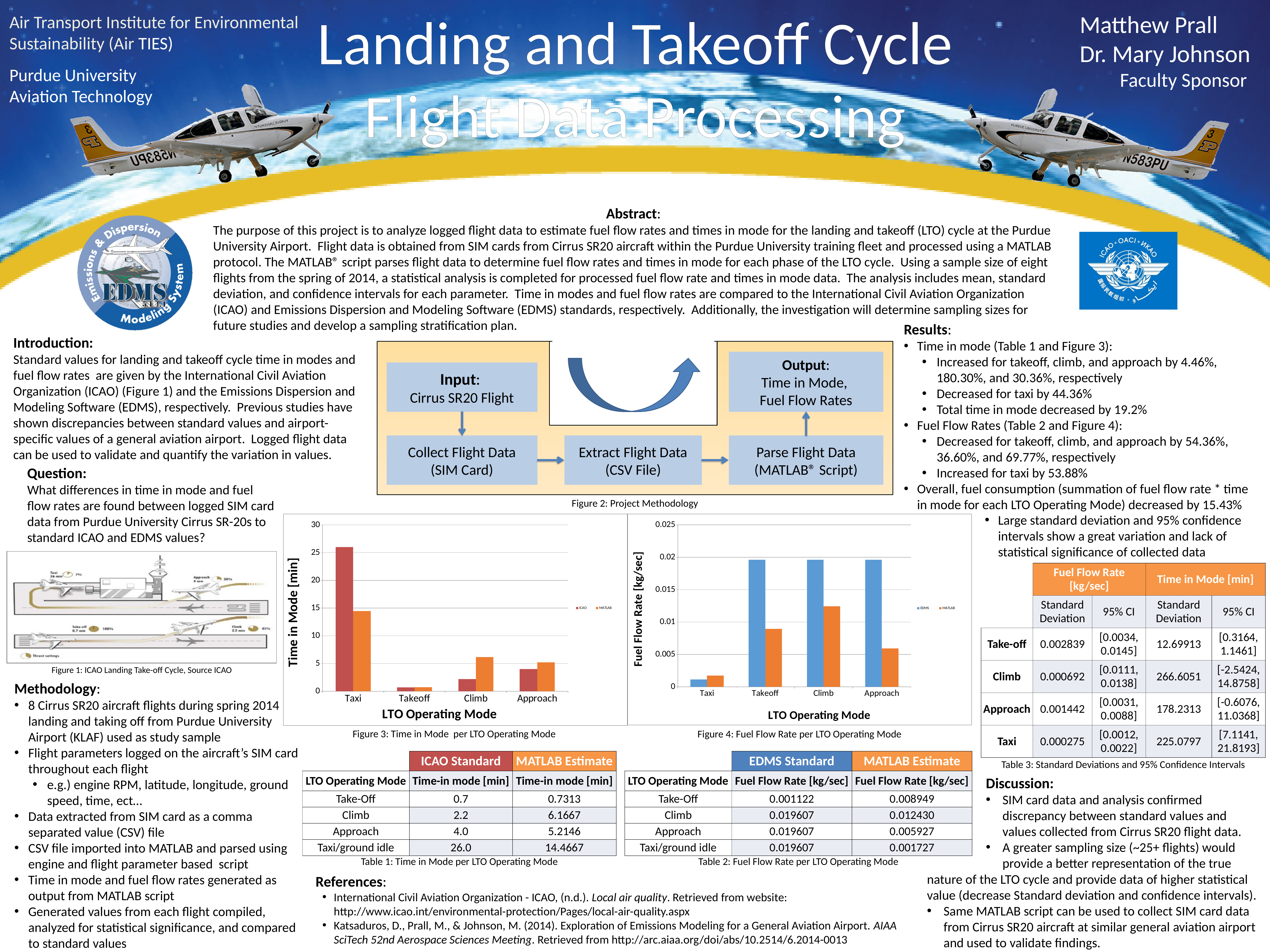
In Figure 3: Time in Mode per LTO Operating Mode, how many series does the legend list? 2 In Figure 3: Time in Mode per LTO Operating Mode, which operating mode has the highest ICAO time in mode? Taxi In Figure 3: Time in Mode per LTO Operating Mode, what kind of chart is shown? bar chart In Figure 3: Time in Mode per LTO Operating Mode, for Climb, which is larger: the ICAO value or the MATLAB value? MATLAB In Figure 4: Fuel Flow Rate per LTO Operating Mode, for Takeoff, which is larger: the EDMS value or the MATLAB value? EDMS In Figure 3: Time in Mode per LTO Operating Mode, is the ICAO value for Taxi greater or less than 20? greater In Figure 4: Fuel Flow Rate per LTO Operating Mode, is the MATLAB value for Approach greater or less than 0.01? less In Figure 4: Fuel Flow Rate per LTO Operating Mode, which operating mode has the lowest MATLAB fuel flow rate? Taxi In Figure 4: Fuel Flow Rate per LTO Operating Mode, how many series does the legend list? 2 In Figure 3: Time in Mode per LTO Operating Mode, what is the label of the x axis? LTO Operating Mode In Figure 3: Time in Mode per LTO Operating Mode, how many LTO operating modes are shown on the x axis? 4 In Figure 4: Fuel Flow Rate per LTO Operating Mode, what kind of chart is shown? bar chart